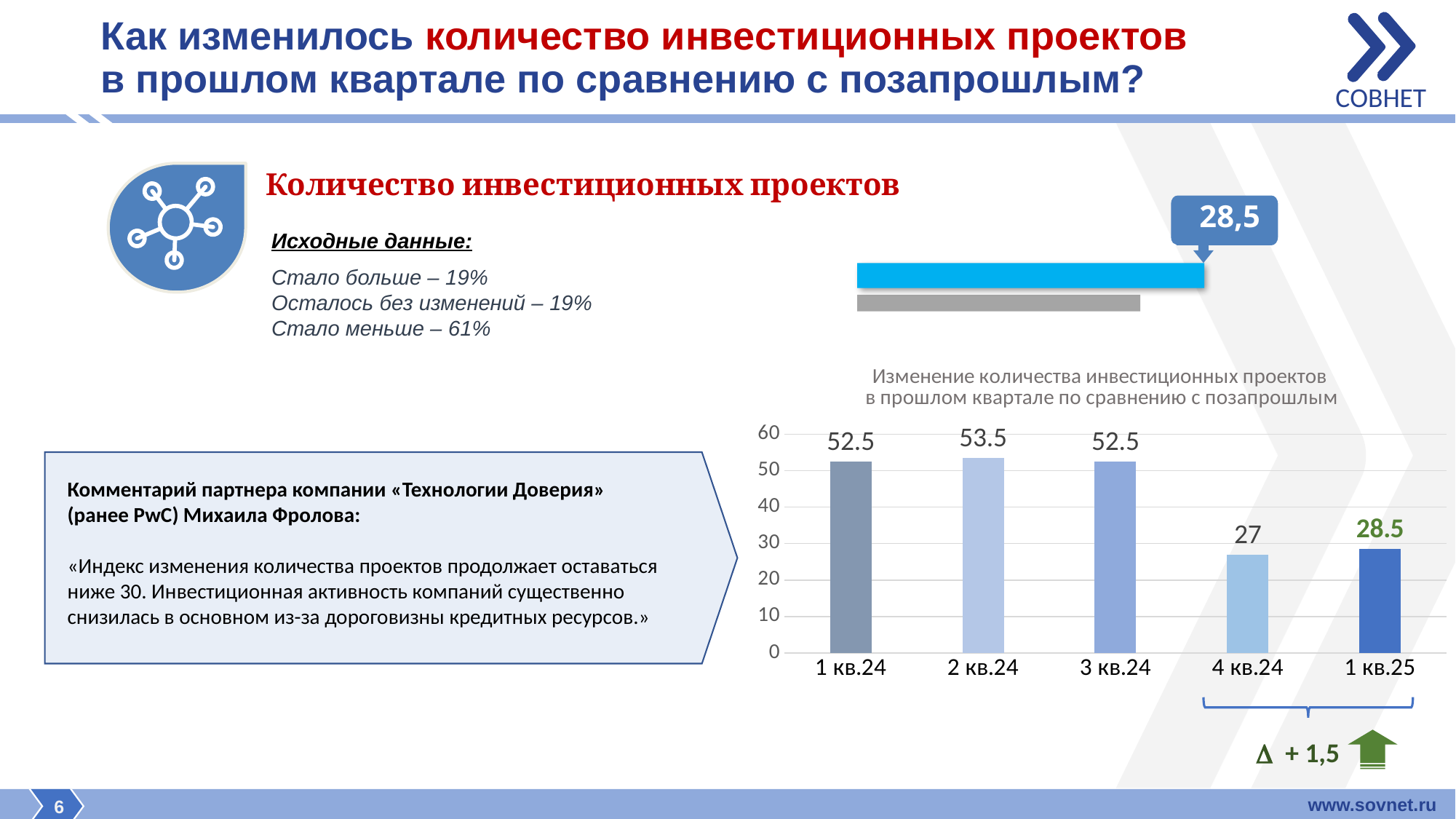
Which is larger, the value for 1 кв.25 or the value for 4 кв.24? 1 кв.25 How many quarters are shown on the x axis of the bar chart? 5 Is the value for 4 кв.24 greater or less than 30? less What is the difference between the values for 2 кв.24 and 3 кв.24? 1 What is the value for 1 кв.25 in the bar chart? 28.5 What is the value for 1 кв.24 in the bar chart? 52.5 Which quarter has the highest value in the bar chart? 2 кв.24 What is the value for 2 кв.24 in the bar chart? 53.5 What is the value for 4 кв.24 in the bar chart? 27 Which quarter has the lowest value in the bar chart? 4 кв.24 What kind of chart is used to show the change in the number of investment projects? bar chart What is the difference between the values for 1 кв.25 and 4 кв.24? 1.5